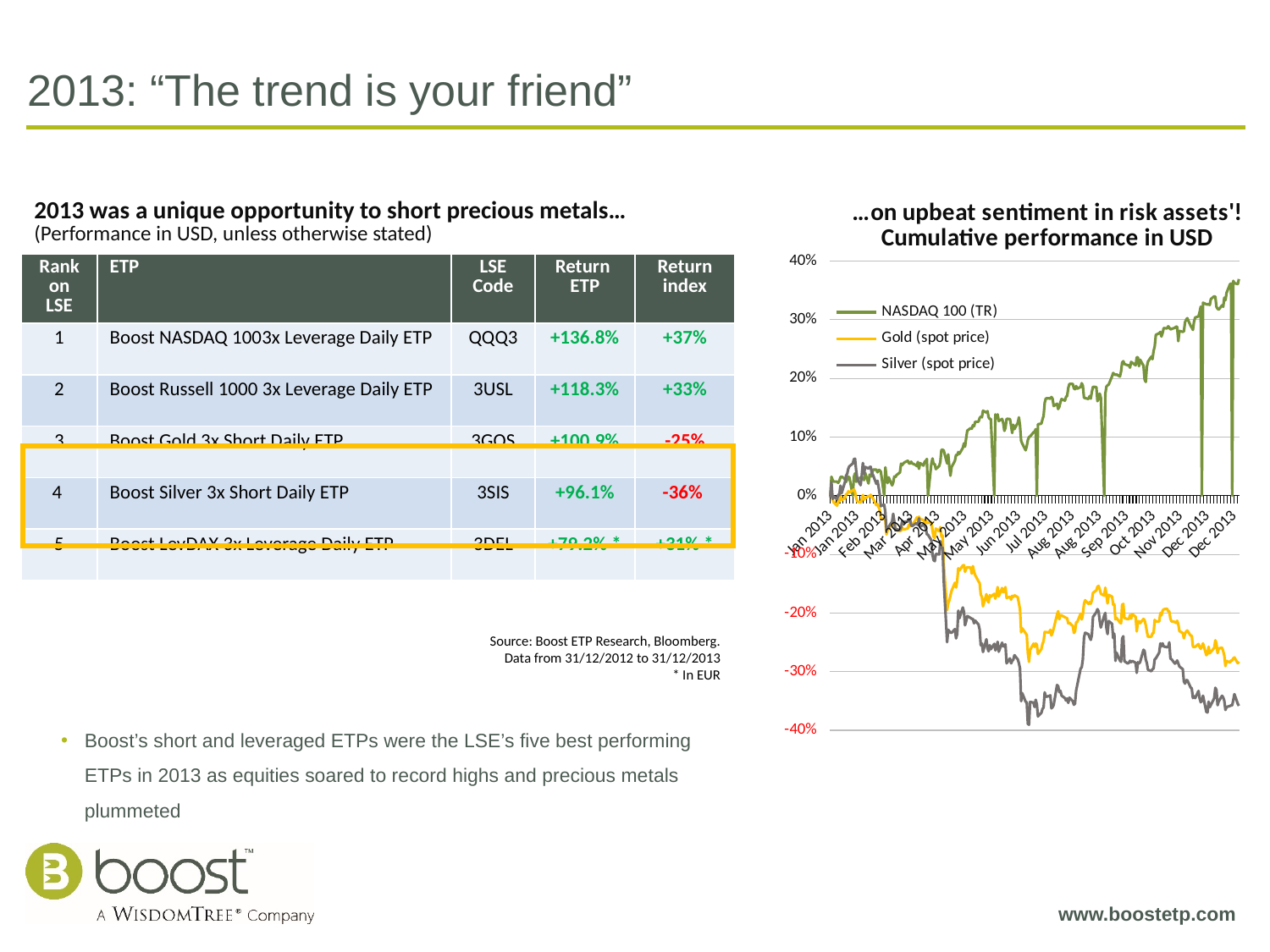
In the cumulative performance chart, does the Silver (spot price) line rise or fall over the course of 2013? Fall How many series does the legend of the cumulative performance chart list? 3 Which series are listed in the legend of the cumulative performance chart? NASDAQ 100 (TR), Gold (spot price), Silver (spot price) In the cumulative performance chart, is the Gold (spot price) value at the end of Dec 2013 greater or less than -20%? less What is the title of the chart on the right of the slide? ...on upbeat sentiment in risk assets'! Cumulative performance in USD In the cumulative performance chart, which series ends 2013 with the lowest cumulative performance? Silver (spot price) In the cumulative performance chart, which series ends 2013 with the highest cumulative performance? NASDAQ 100 (TR) In the cumulative performance chart, does the NASDAQ 100 (TR) line rise or fall over the course of 2013? Rise In the cumulative performance chart, is the NASDAQ 100 (TR) value at the end of Dec 2013 greater or less than 30%? greater In the cumulative performance chart, at the end of Dec 2013, which is higher: Gold (spot price) or Silver (spot price)? Gold (spot price) In the cumulative performance chart, is the Silver (spot price) value at the end of Dec 2013 greater or less than -30%? less What kind of chart is shown on the right side of the slide? Line chart